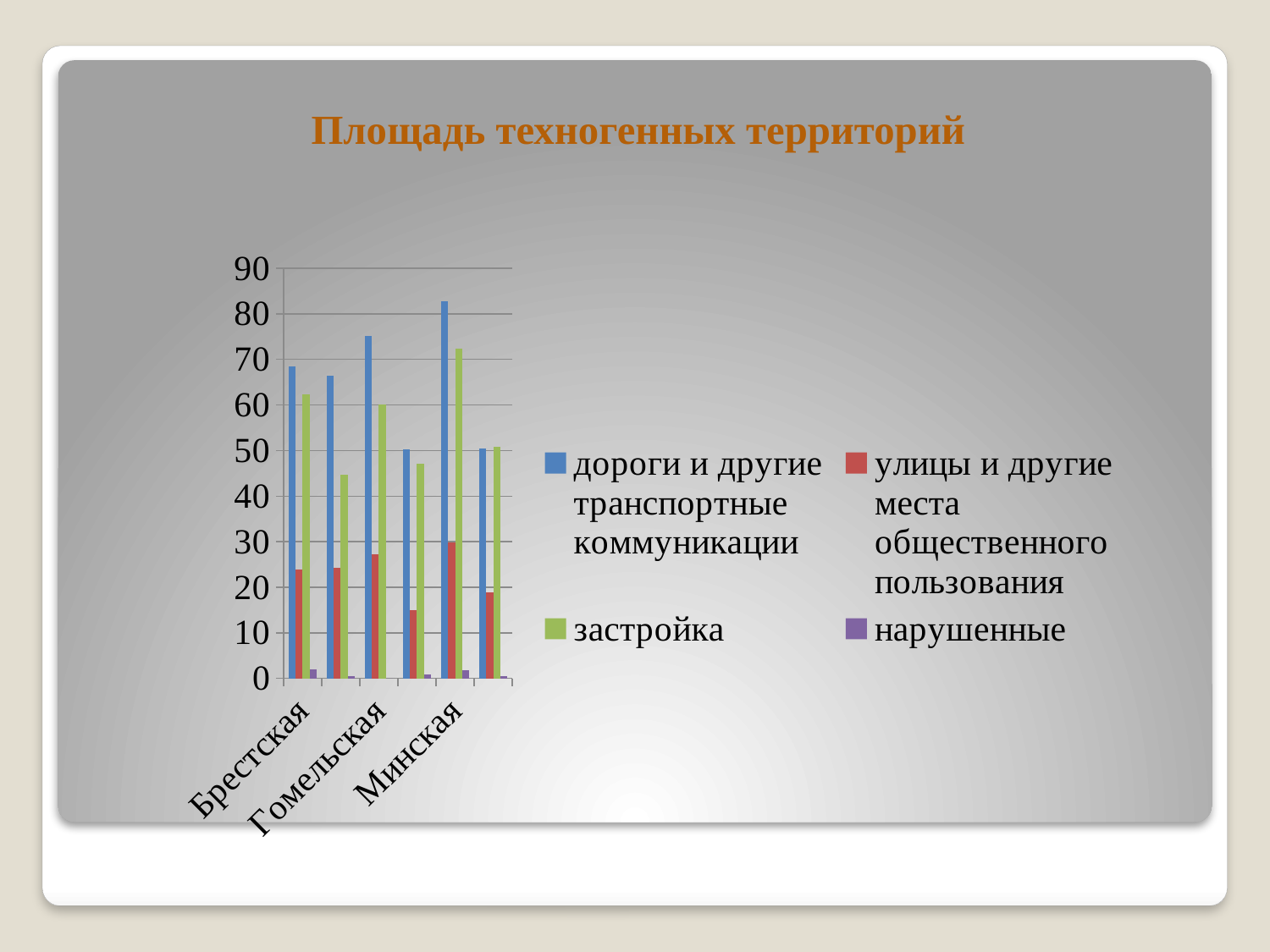
How many series does the legend list? 4 Is the value for застройка in Гомельская greater or less than 70? less Among the labelled regions Брестская, Гомельская and Минская, which has the highest value for дороги и другие транспортные коммуникации? Минская Is the value for дороги и другие транспортные коммуникации in Гомельская greater or less than 70? greater What kind of chart is shown on the slide? bar chart Which has the larger value for дороги и другие транспортные коммуникации, Брестская or Минская? Минская Is the value for застройка in Минская greater or less than 60? greater Which series is shown in green in the legend? застройка What is the title of the chart? Площадь техногенных территорий In Брестская, which is larger: застройка or улицы и другие места общественного пользования? застройка